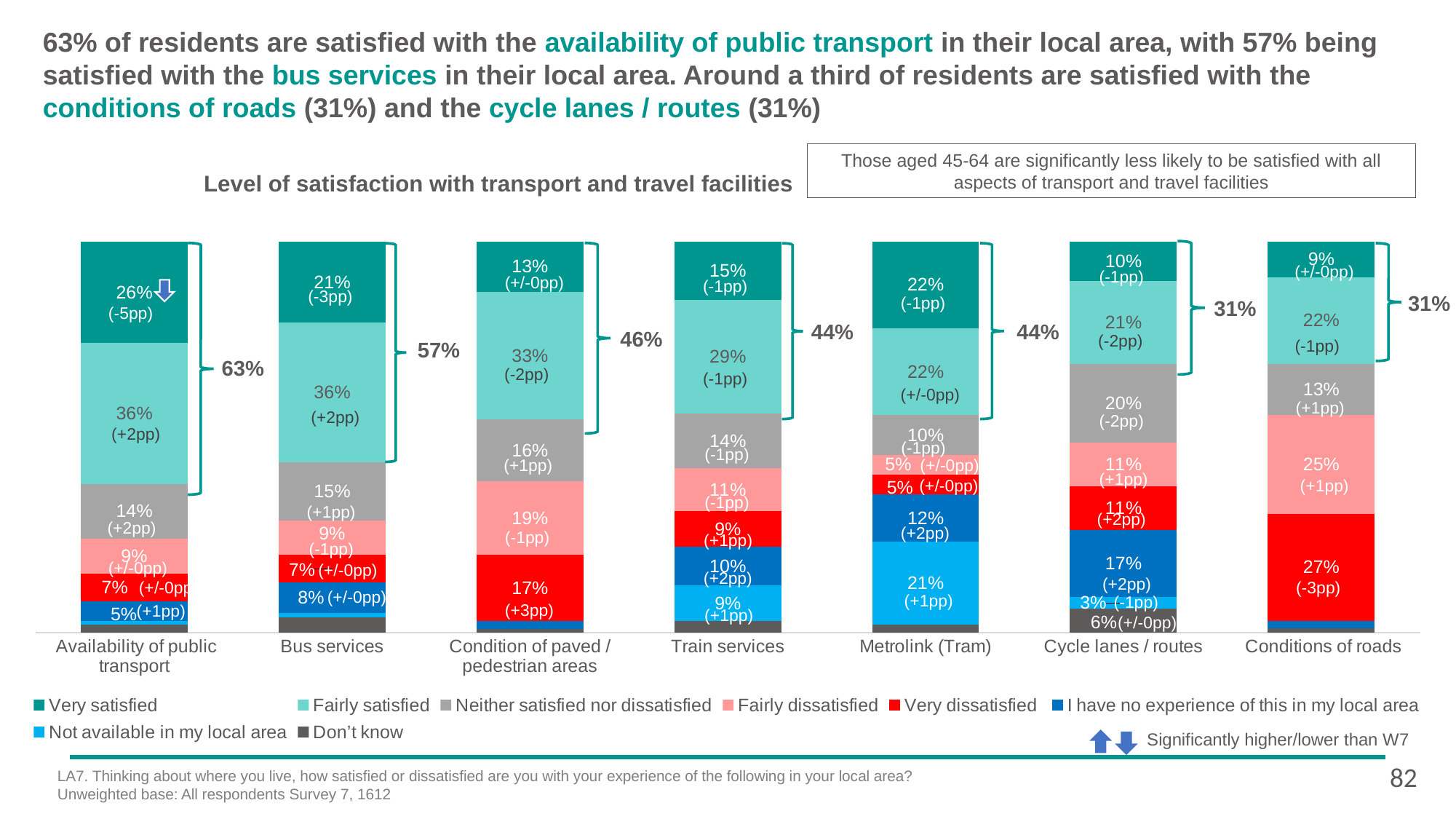
Which is larger: the 'Very satisfied' value for Metrolink (Tram) or for Train services? Metrolink (Tram) What is the 'Very satisfied' value for Availability of public transport? 26% What is the 'Not available in my local area' value for Metrolink (Tram)? 21% How many categories are shown along the x axis of the chart? 7 What type of chart is shown on the slide? Stacked bar chart What is the title of the chart? Level of satisfaction with transport and travel facilities What is the difference between the combined satisfied share for Bus services and for Train services? 13% Which category has the highest combined satisfied share shown by the bracket labels? Availability of public transport How many series does the legend list? 8 Which category has the highest 'Very dissatisfied' value? Conditions of roads What is the 'Very dissatisfied' value for Conditions of roads? 27% What is the 'Fairly satisfied' value for Condition of paved / pedestrian areas? 33%